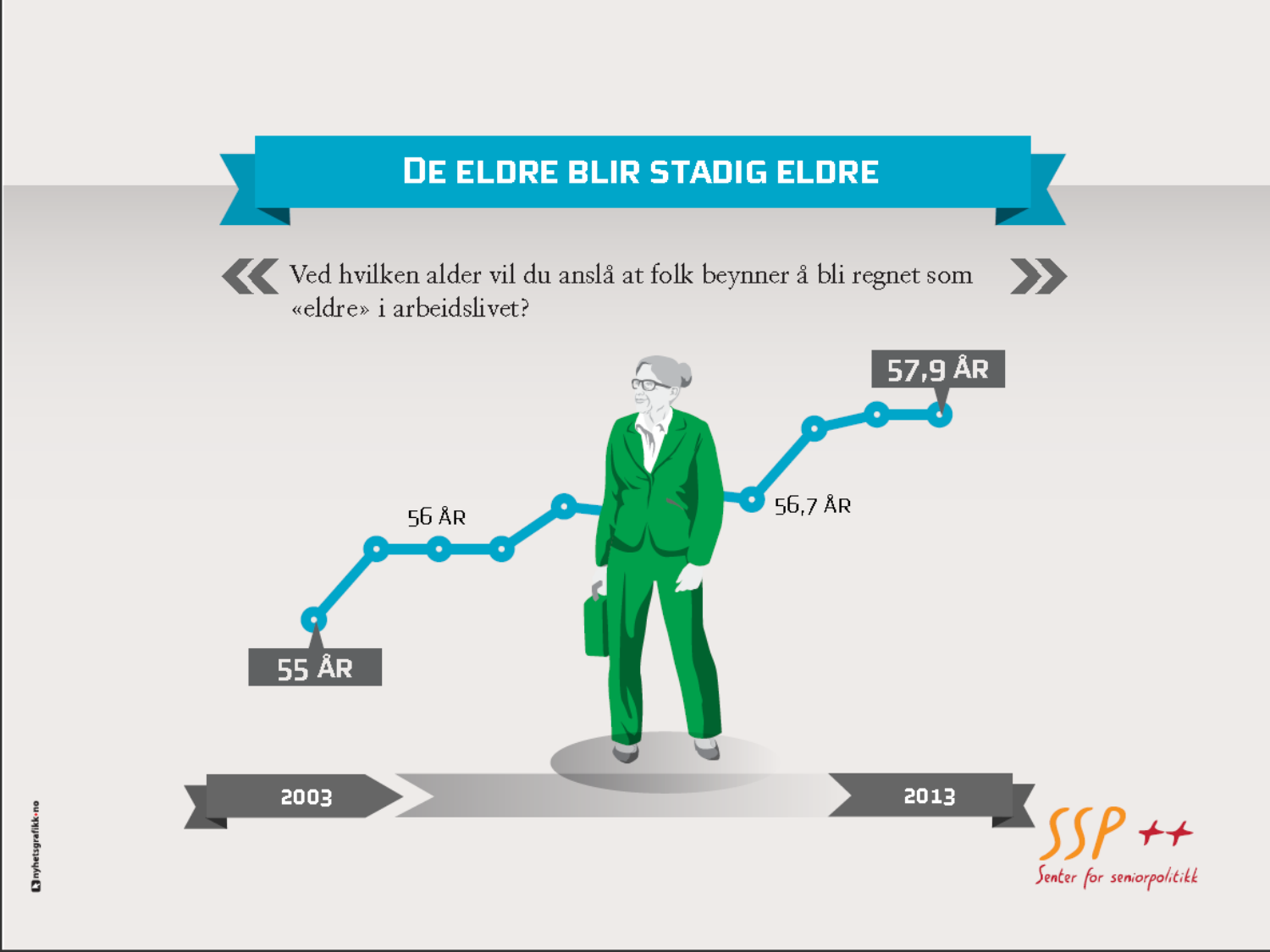
What colour is the line on the chart? blue What is the title of the chart? De eldre blir stadig eldre Which year shown on the chart has the highest value? 2013 Which year shown on the chart has the lowest value? 2003 Do the values rise or fall from 2003 to 2013? rise What value is labelled for 2013 on the chart? 57,9 år What is the difference between the 2013 value and the 2003 value? 2,9 år What is the difference between the labelled values 57,9 år and 56,7 år? 1,2 år Which year has the higher value, 2003 or 2013? 2013 What is the difference between the labelled values 56,7 år and 56 år? 0,7 år What value is labelled for 2003 on the chart? 55 år What kind of chart is shown on the slide? line chart